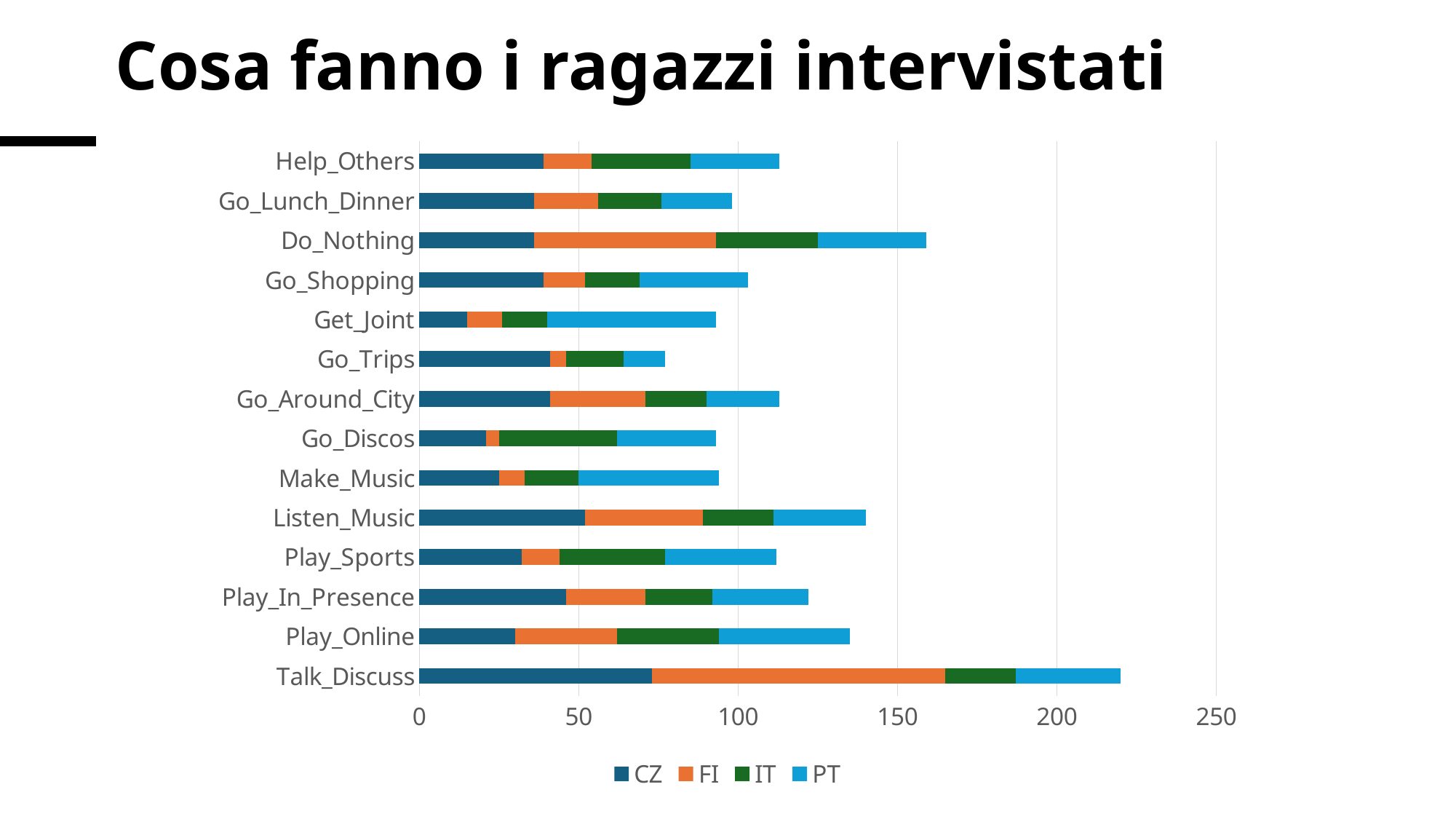
Which has the larger total bar, Go_Shopping or Go_Trips? Go_Shopping How many series does the legend list? 4 How many activity categories are plotted on the chart? 14 What kind of chart is shown on the slide? Stacked bar chart Which has the larger total bar, Do_Nothing or Listen_Music? Do_Nothing Which activity has the lowest total bar? Go_Trips Is the total value for Do_Nothing greater or less than 150? greater Is the total value for Talk_Discuss greater or less than 200? greater Is the total value for Play_Online greater or less than 100? greater What is the title of the slide? Cosa fanno i ragazzi intervistati Which activity has the highest total bar? Talk_Discuss